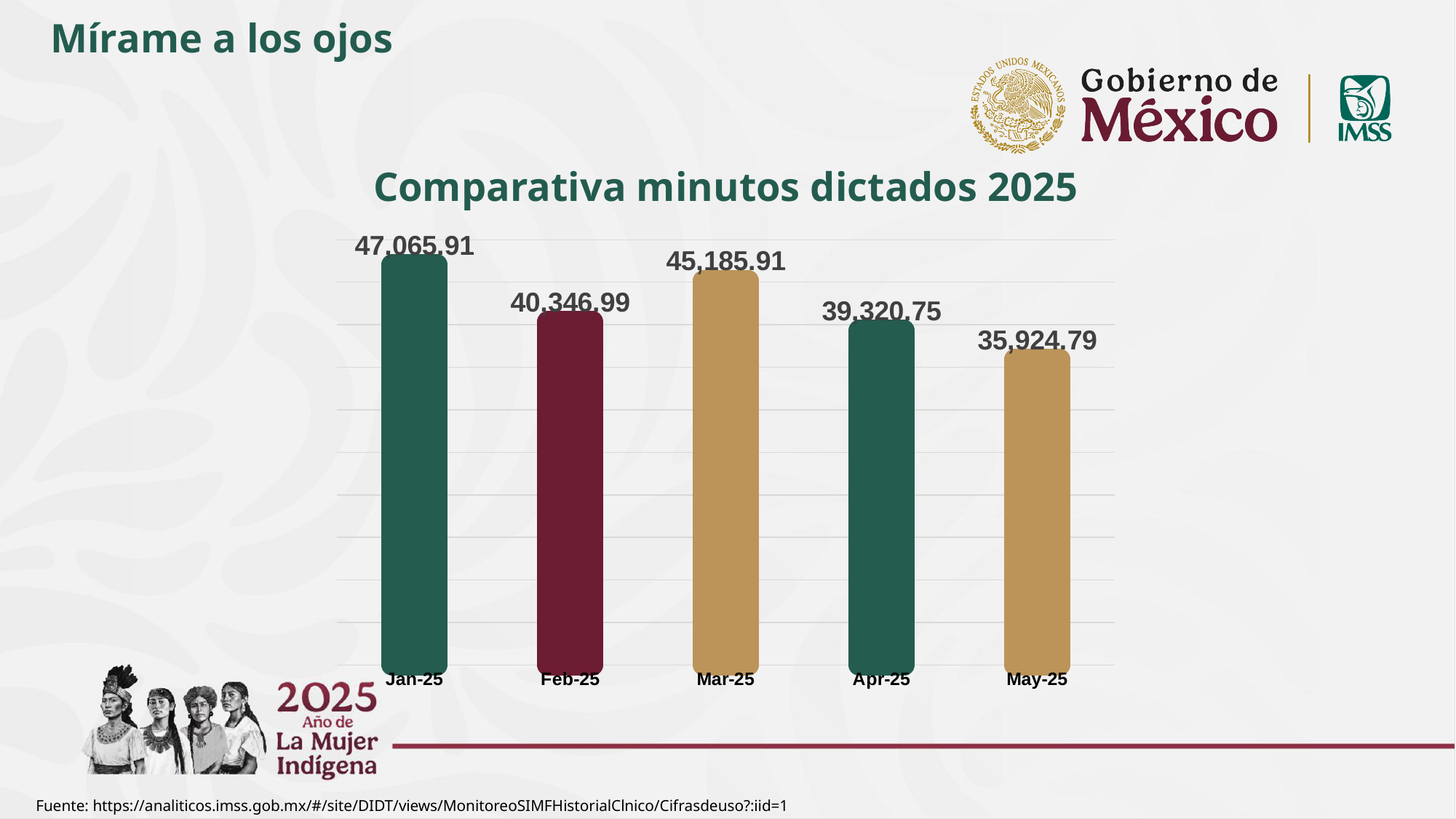
From Mar-25 to May-25, do the values rise or fall? Fall Which month has the highest value in the chart? Jan-25 What is the value for May-25 in the chart? 35,924.79 What is the difference between the values for Mar-25 and Apr-25? 5,865.16 What is the difference between the values for Jan-25 and May-25? 11,141.12 How many months are shown in the chart? 5 Which month has the lowest value in the chart? May-25 What is the value for Mar-25 in the chart? 45,185.91 What is the value for Jan-25 in the chart? 47,065.91 Which is larger, the value for Feb-25 or the value for Apr-25? Feb-25 What kind of chart is shown on the slide? Bar chart What is the value for Feb-25 in the chart? 40,346.99